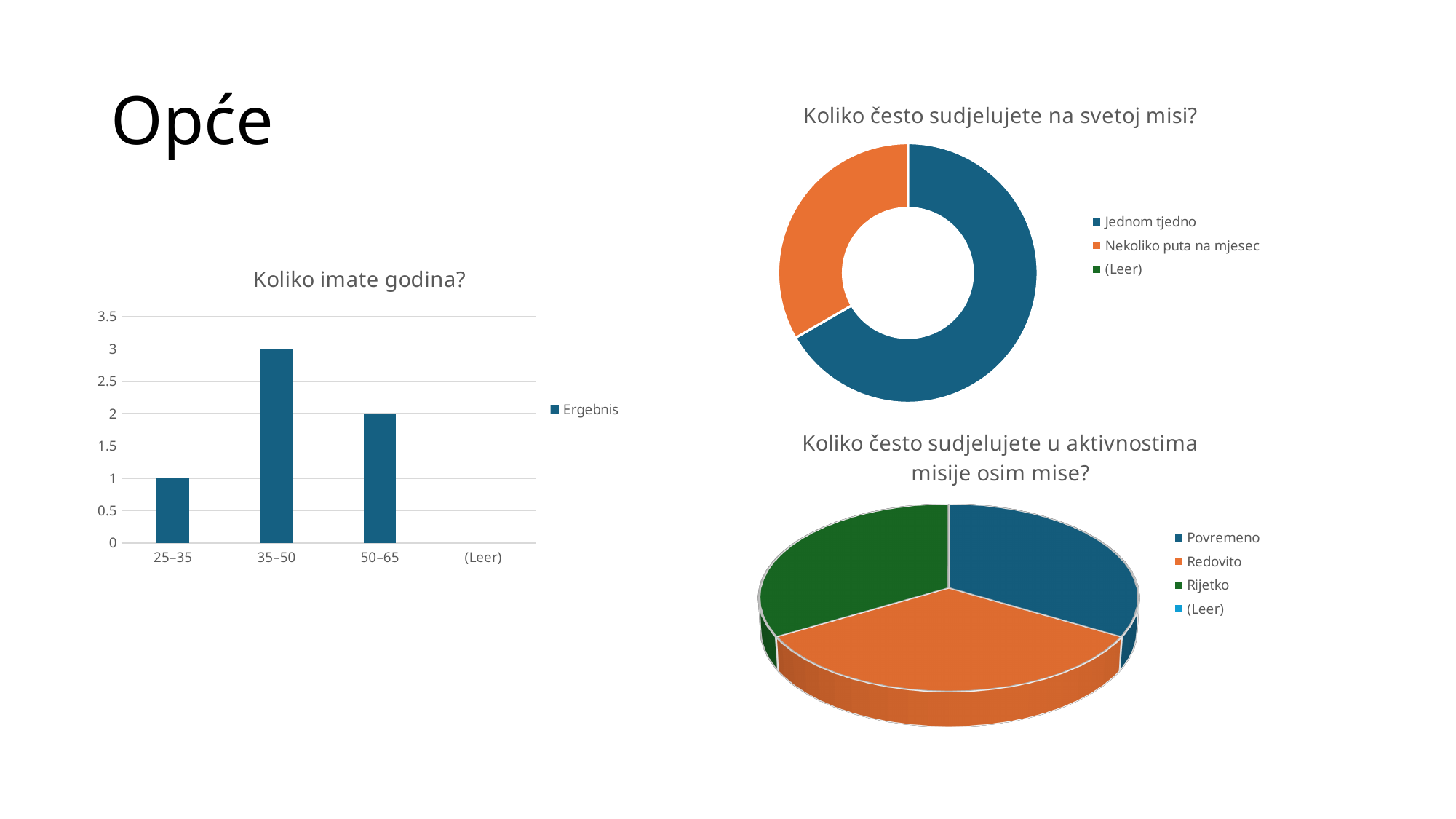
In the chart titled "Koliko imate godina?", what is the value for the 25–35 category? 1 What kind of chart is "Koliko imate godina?"? Bar chart In the chart titled "Koliko imate godina?", what is the difference between the values for 35–50 and 25–35? 2 How many entries does the legend of the chart titled "Koliko često sudjelujete u aktivnostima misije osim mise?" list? 4 In the chart titled "Koliko često sudjelujete na svetoj misi?", which category has the largest share? Jednom tjedno In the chart titled "Koliko imate godina?", what is the value for the 35–50 category? 3 In the chart titled "Koliko imate godina?", what series name does the legend show? Ergebnis In the chart titled "Koliko imate godina?", what is the value for the 50–65 category? 2 What kind of chart is "Koliko često sudjelujete u aktivnostima misije osim mise?"? Pie chart In the chart titled "Koliko imate godina?", which is larger, the value for 50–65 or the value for 25–35? 50–65 In the chart titled "Koliko imate godina?", how many categories are shown on the x axis? 4 In the chart titled "Koliko imate godina?", which category has the highest value? 35–50